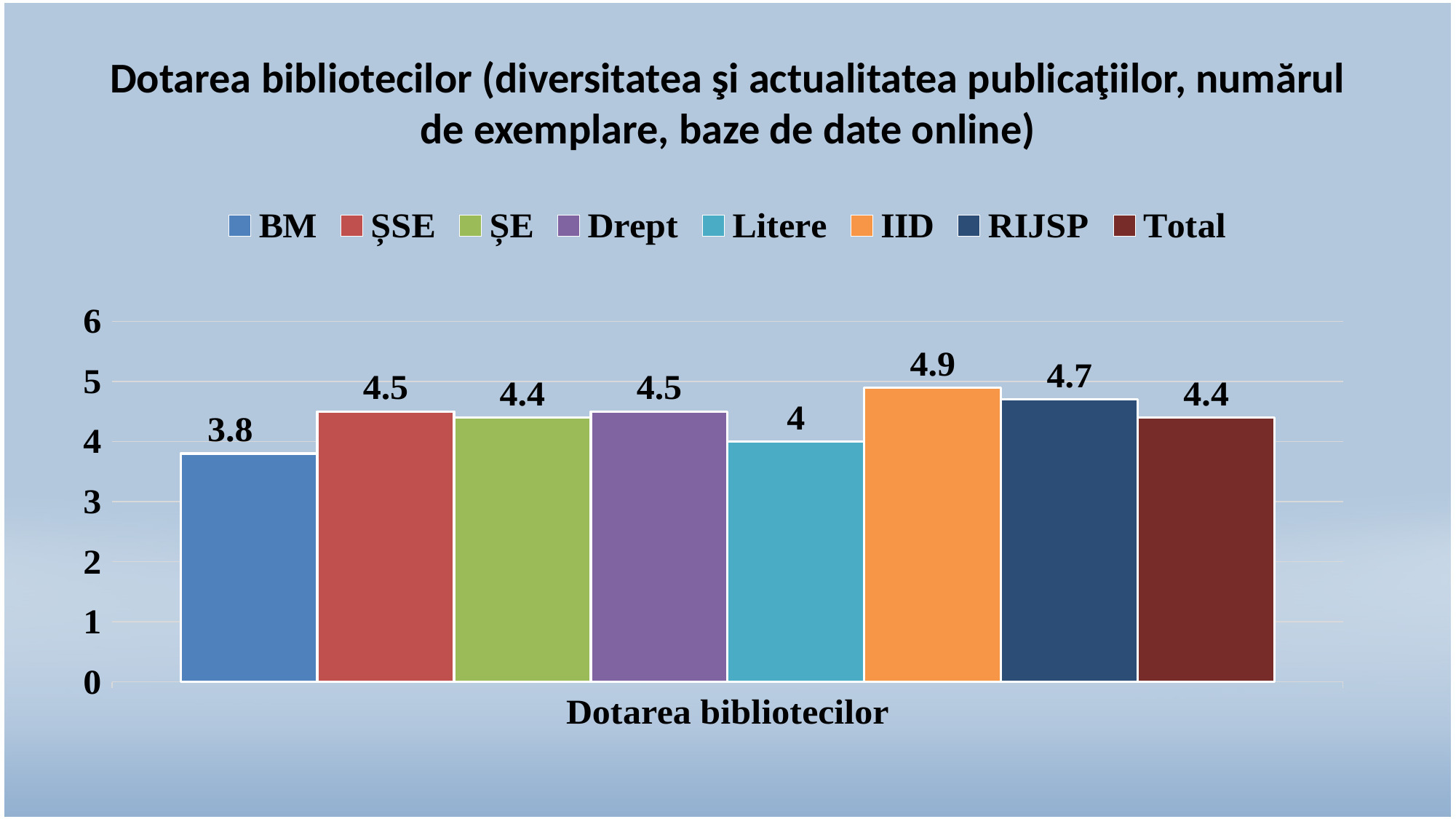
Which series has the lowest value? BM What is the value for BM? 3.8 What is the difference between the values for IID and BM? 1.1 What kind of chart is shown on the slide? bar chart What is the x-axis label of the chart? Dotarea bibliotecilor Is the value for BM greater or less than 4? less What is the value for Litere? 4 Which is larger, the value for RIJSP or the value for Litere? RIJSP What is the value for IID? 4.9 How many series does the legend list? 8 What is the value for Total? 4.4 Which series has the highest value? IID